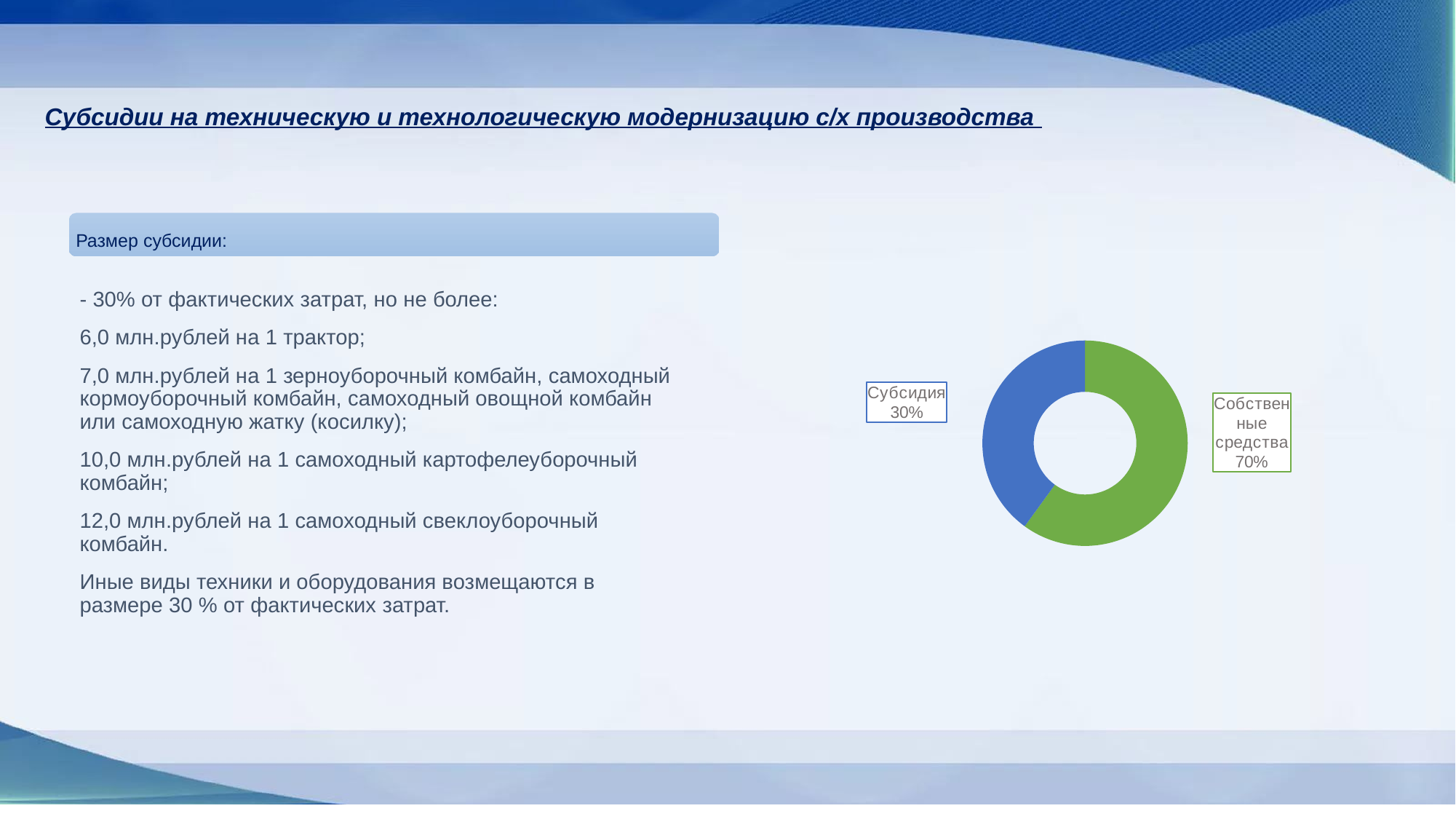
Which slice of the chart is the smallest? Субсидия Which is larger: the "Субсидия" slice or the "Собственные средства" slice? Собственные средства What is the total of the two slices shown in the chart? 100% What colour is the "Собственные средства" slice? Green What colour is the "Субсидия" slice? Blue What kind of chart is shown on the slide? Doughnut chart Which slice of the chart is the largest? Собственные средства How many slices does the chart have? 2 What share of the doughnut chart does "Собственные средства" represent? 70% What share of the doughnut chart does "Субсидия" represent? 30% What is the difference in percentage points between the "Собственные средства" and "Субсидия" slices? 40